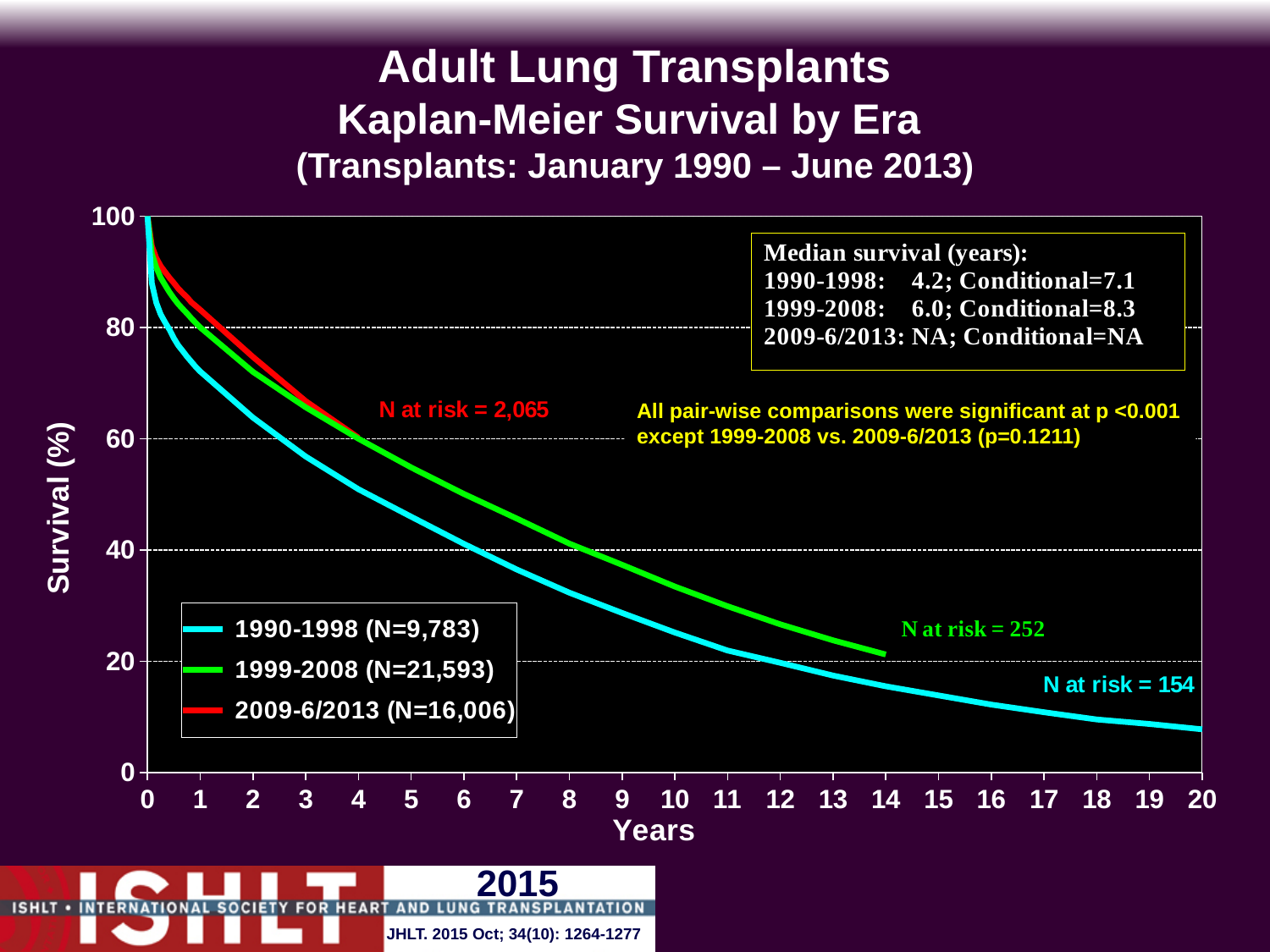
Is the survival for the 1990-1998 era at year 20 greater or less than 20? less Do the survival curves rise or fall as years increase? Fall At year 5, which era has higher survival, 1990-1998 or 1999-2008? 1999-2008 What is the median survival in years for the 1990-1998 era? 4.2 What is the conditional median survival for the 1999-2008 era? 8.3 What is the N shown in the legend for the 1999-2008 era? 21,593 What kind of chart is shown on the slide? Line chart What is the N at risk printed for the 1999-2008 era? 252 What is the N at risk printed for the 2009-6/2013 era? 2,065 What is the difference in median survival (years) between the 1999-2008 and 1990-1998 eras? 1.8 Is the survival for the 1999-2008 era at year 5 greater or less than 40? greater How many series does the legend list? 3